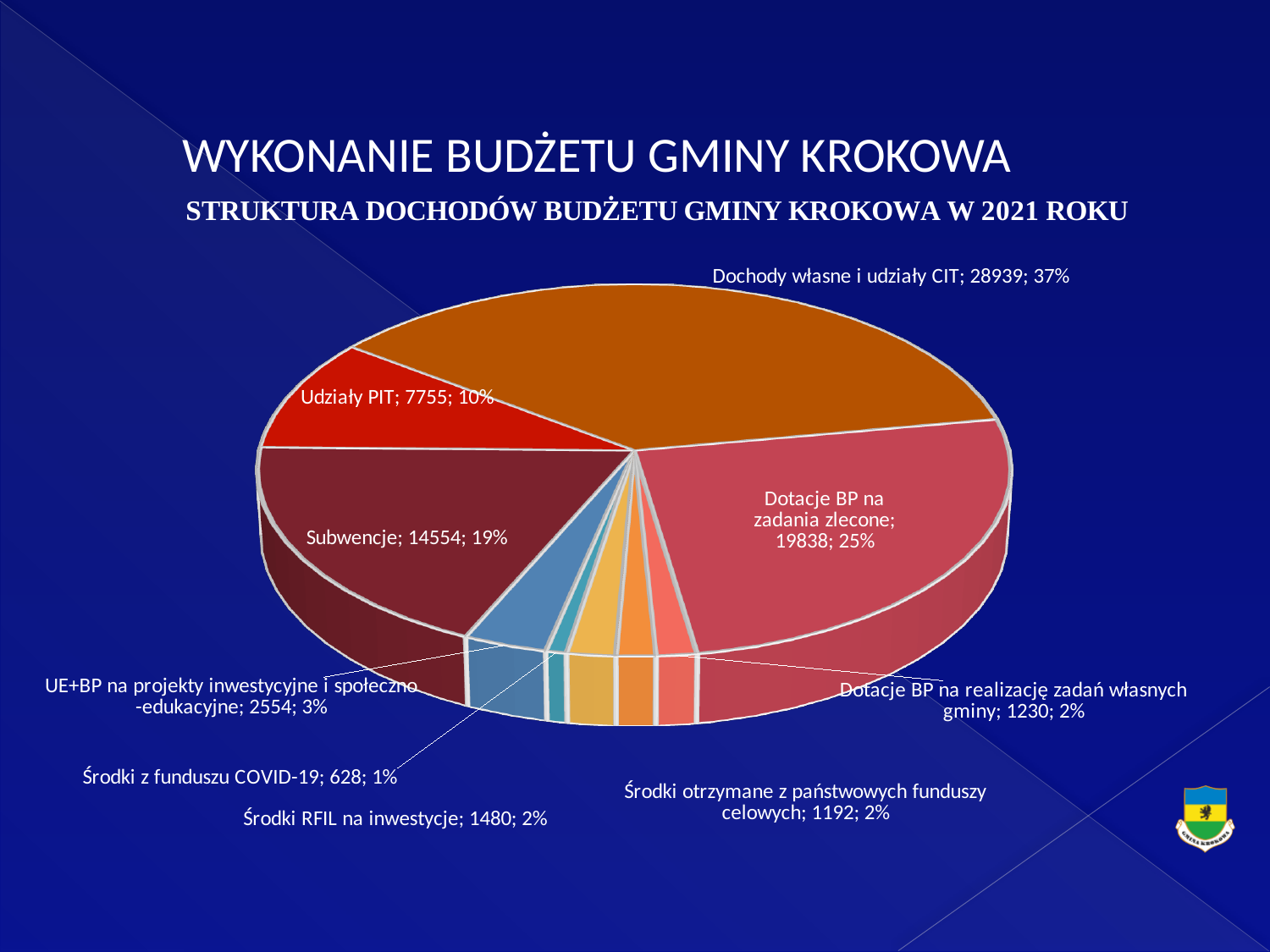
What kind of chart is shown on the slide? pie chart What share of the pie does Dotacje BP na zadania zlecone represent? 25% What is the value for Środki RFIL na inwestycje? 1480 What is the difference between the values for Dochody własne i udziały CIT and Dotacje BP na zadania zlecone? 9101 What share of the pie does Udziały PIT represent? 10% What is the subtitle of the chart shown on the slide? STRUKTURA DOCHODÓW BUDŻETU GMINY KROKOWA W 2021 ROKU Which is larger, the value for Subwencje or the value for Udziały PIT? Subwencje Which category has the largest slice of the pie? Dochody własne i udziały CIT What is the value for Subwencje? 14554 What is the value for Dochody własne i udziały CIT? 28939 Which category has the smallest slice of the pie? Środki z funduszu COVID-19 How many slices does the pie chart have? 9